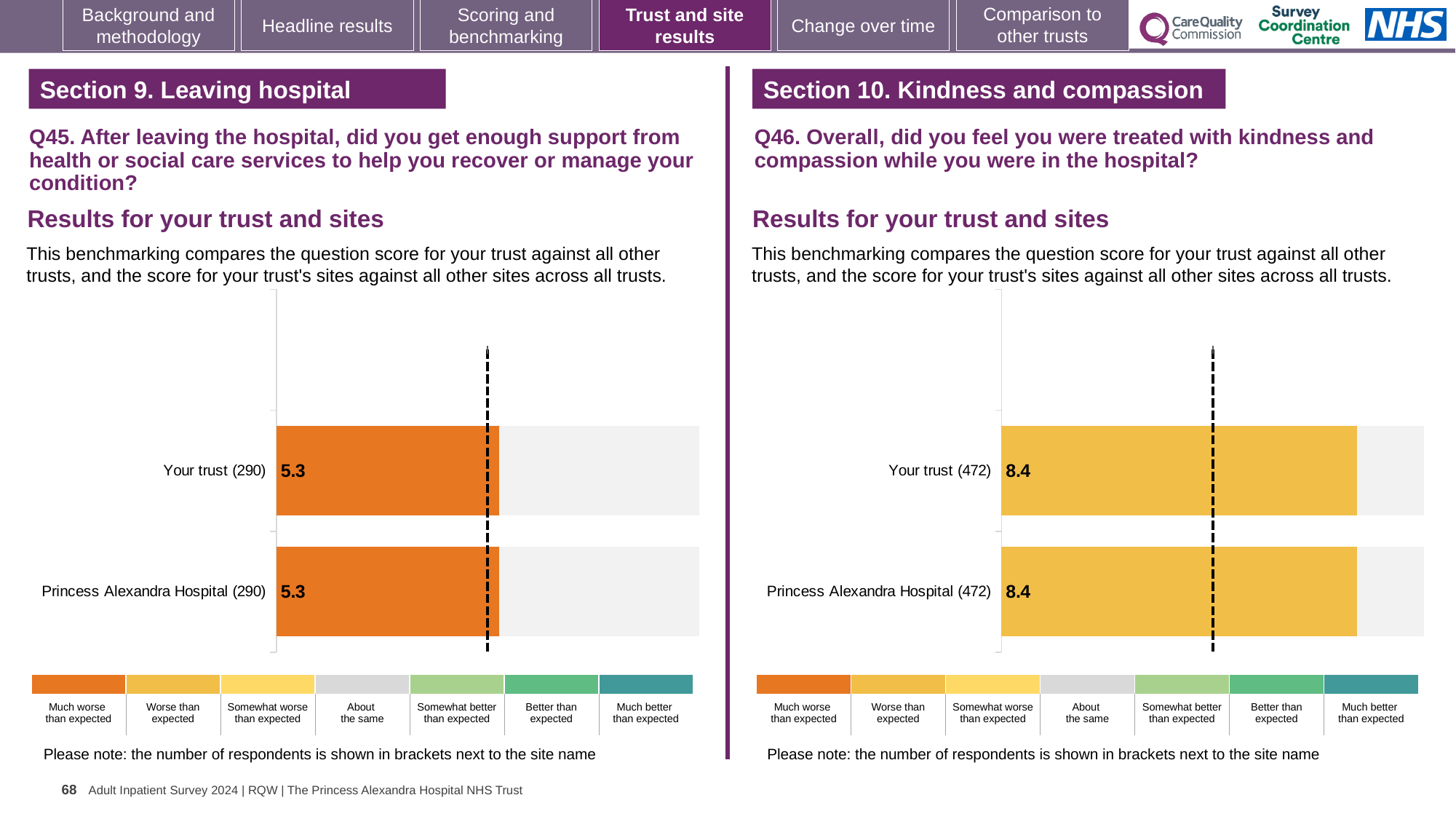
In the Q45 chart on the left, what is the score for Princess Alexandra Hospital? 5.3 In the Q45 chart on the left, what is the difference between the score for Your trust and the score for Princess Alexandra Hospital? 0 In the Q46 chart on the right, what is the difference between the score for Your trust and the score for Princess Alexandra Hospital? 0 In the Q46 chart on the right, what is the score for Your trust? 8.4 How many bars are plotted in the Q46 chart on the right? 2 In the Q46 chart on the right, what is the score for Princess Alexandra Hospital? 8.4 In the Q45 chart on the left, how many respondents are shown in brackets next to Your trust? 290 What kind of chart is the Q45 chart on the left? Bar chart In the Q45 chart on the left, what is the score for Your trust? 5.3 How many bars are plotted in the Q45 chart on the left? 2 In the Q46 chart on the right, how many respondents are shown in brackets next to Princess Alexandra Hospital? 472